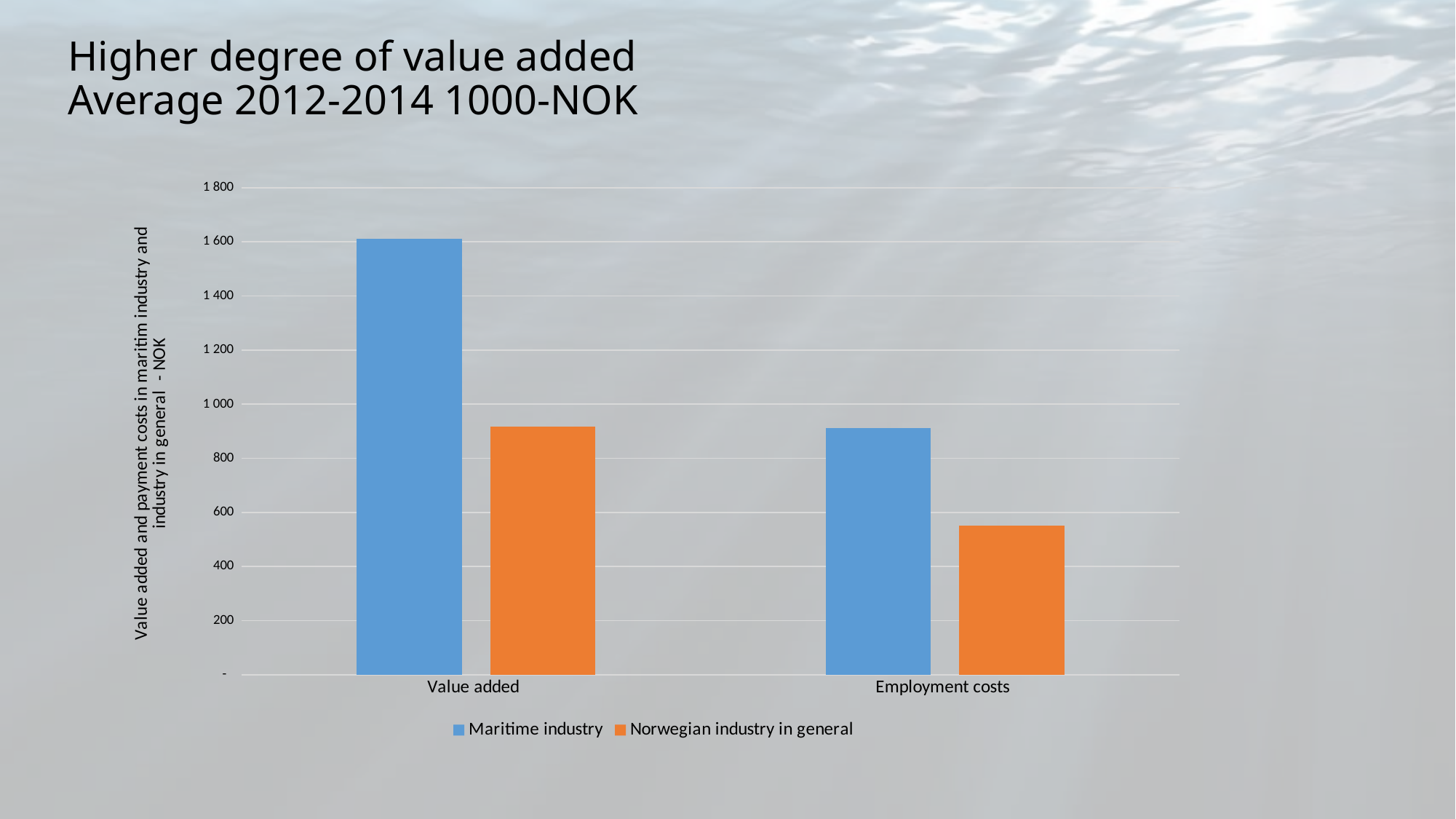
Is the Norwegian industry in general value for Employment costs greater or less than 600? less Is the Maritime industry value for Employment costs greater or less than 800? greater How many series does the legend list? 2 Is the Maritime industry value for Value added greater or less than 1 400? greater For Value added, which is larger: Maritime industry or Norwegian industry in general? Maritime industry What is the title of the chart? Higher degree of value added Average 2012-2014 1000-NOK For Employment costs, which is larger: Maritime industry or Norwegian industry in general? Maritime industry What kind of chart is shown on the slide? bar chart How many categories are shown on the x axis? 2 Which bar is the tallest in the chart? Maritime industry, Value added Which series is shown in orange? Norwegian industry in general